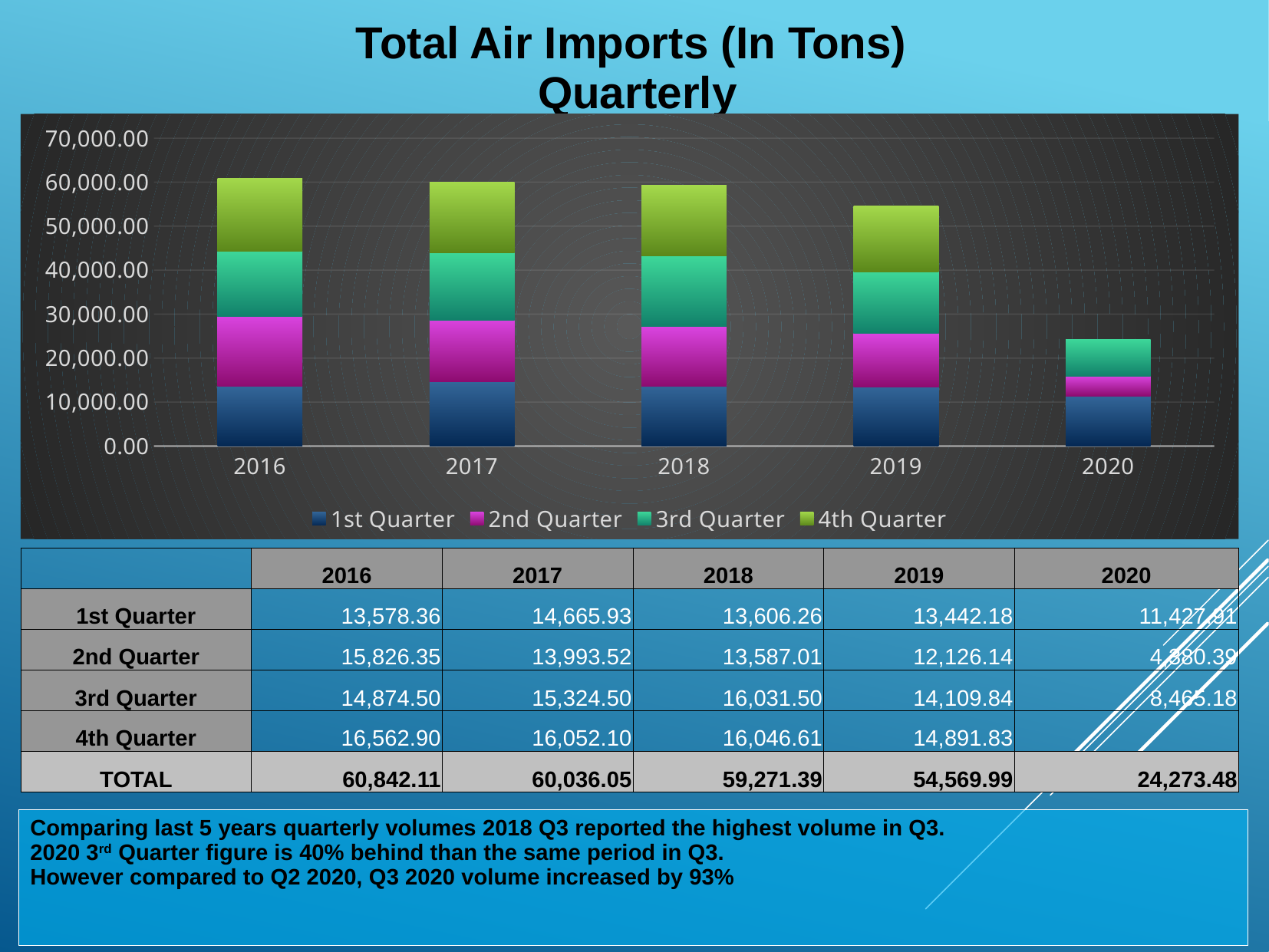
What is the 4th Quarter value for 2019? 14,891.83 Which year has the highest total air imports? 2016 Do the yearly totals rise or fall from 2016 to 2020? fall What is the difference between the 3rd Quarter value for 2018 and the 3rd Quarter value for 2019? 1,921.66 Which year has the lowest total air imports? 2020 What is the total of the stacked bar for 2016? 60,842.11 How many series does the legend list? 4 What is the 1st Quarter value for 2016? 13,578.36 Is the total for 2020 greater or less than 30,000.00? less How many years are shown on the x axis of the chart? 5 Which year has the larger 2nd Quarter value, 2016 or 2017? 2016 What kind of chart is shown on the slide? Stacked bar chart